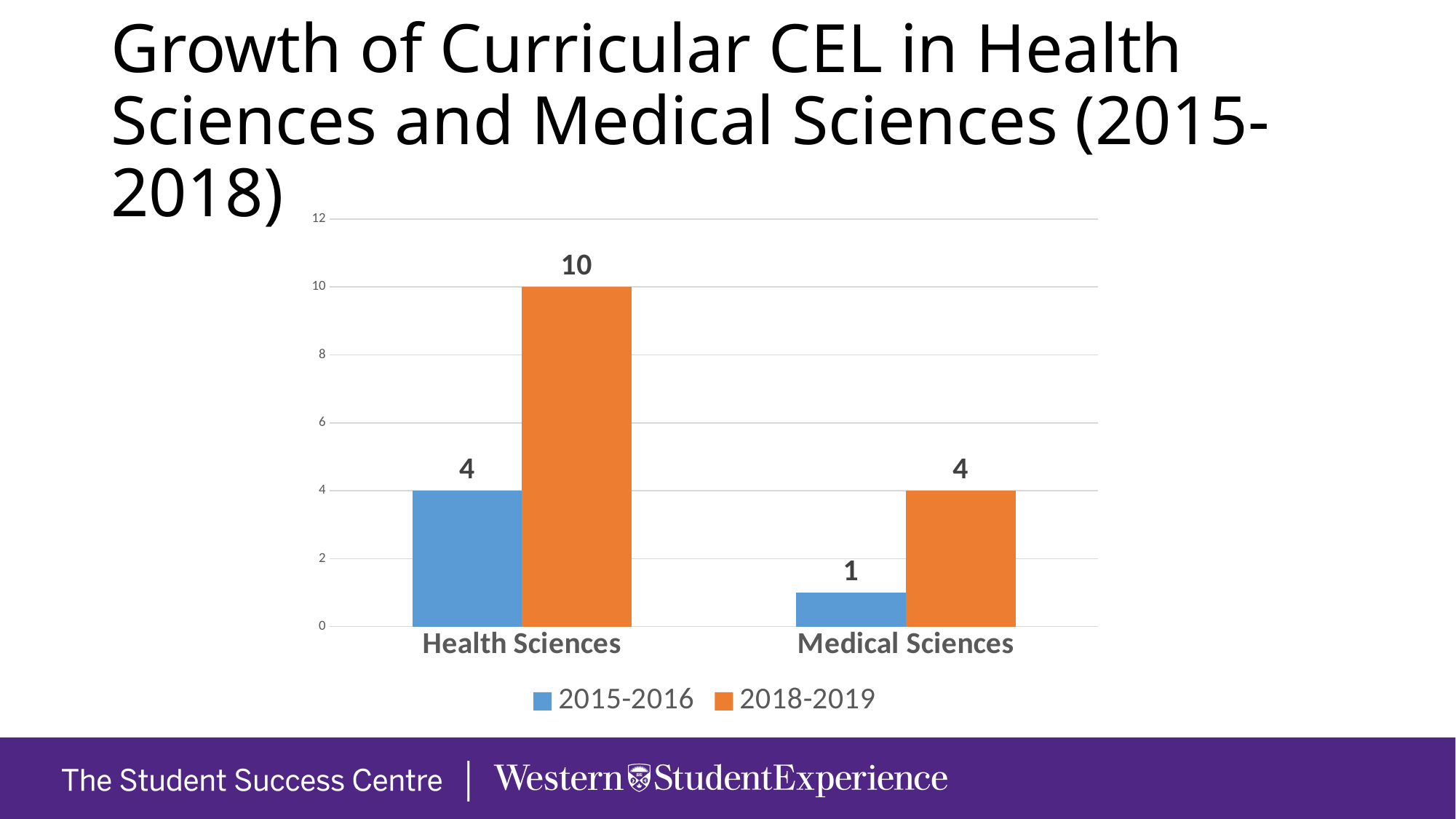
What is the value for Medical Sciences in 2015-2016? 1 What is the value for Health Sciences in 2015-2016? 4 How many series does the legend list? 2 What is the value for Health Sciences in 2018-2019? 10 What is the value for Medical Sciences in 2018-2019? 4 What kind of chart is shown on the slide? Bar chart What is the difference between the 2018-2019 and 2015-2016 values for Health Sciences? 6 Which is larger: the 2015-2016 value for Health Sciences or the 2018-2019 value for Medical Sciences? They are equal What is the difference between the 2018-2019 and 2015-2016 values for Medical Sciences? 3 How many categories are shown on the x axis? 2 Which category has the highest value in the 2018-2019 series? Health Sciences Which category has the lowest value in the 2015-2016 series? Medical Sciences